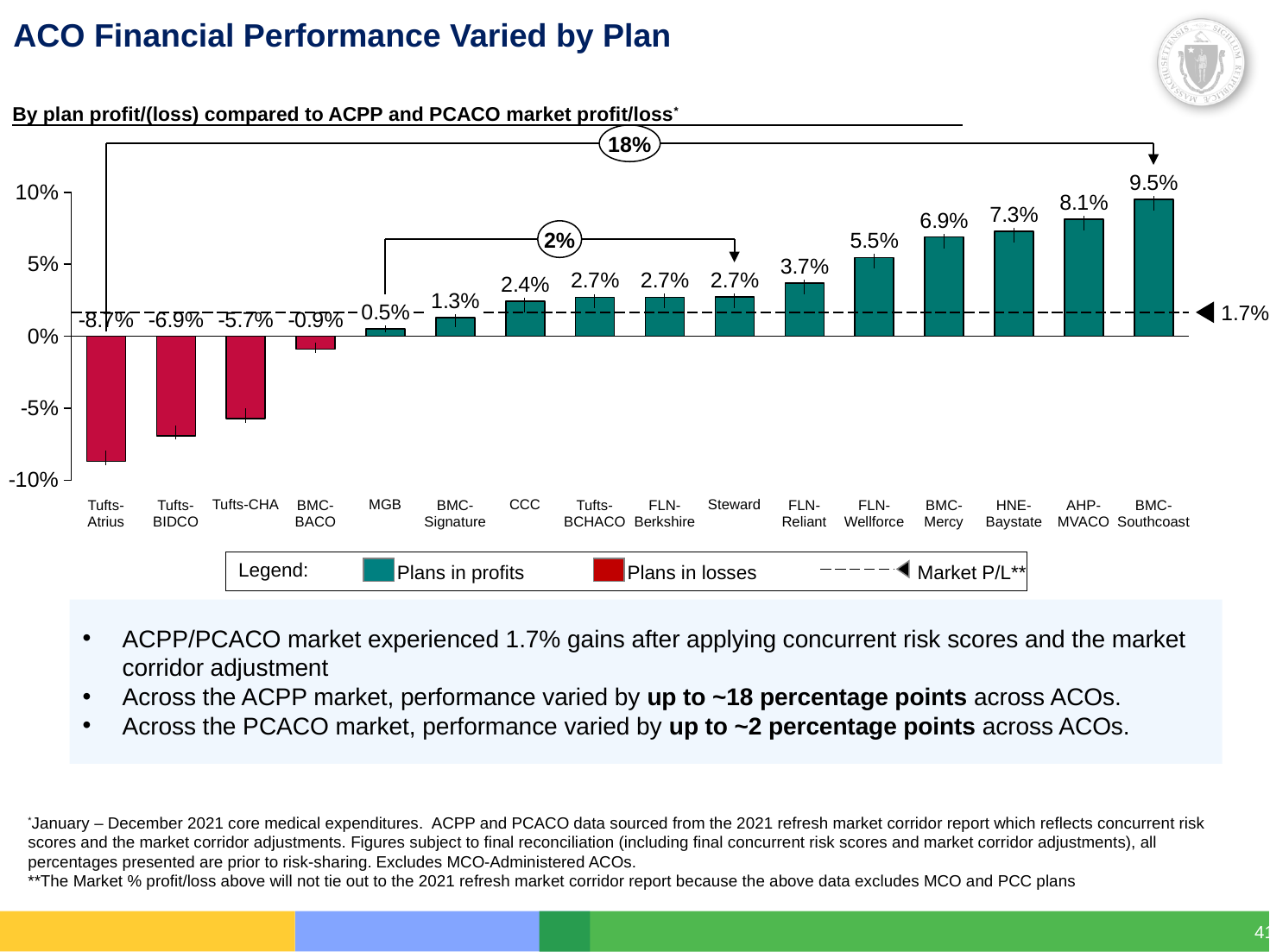
How many plans are shown on the x axis of the chart? 16 Which has a higher value, HNE-Baystate or BMC-Mercy? HNE-Baystate What is the difference between the values for BMC-Southcoast and AHP-MVACO? 1.4 percentage points What is the profit/loss value shown for BMC-Southcoast? 9.5% What kind of chart is shown on the slide? Bar chart Which plan has the highest profit/loss value in the chart? BMC-Southcoast Is the value for Tufts-BIDCO greater or less than -5%? less Which plan has the lowest profit/loss value in the chart? Tufts-Atrius What is the value shown for FLN-Wellforce? 5.5% What is the profit/loss value shown for Tufts-Atrius? -8.7% How many entries does the legend list? 3 What market profit/loss value is marked by the dashed line? 1.7%